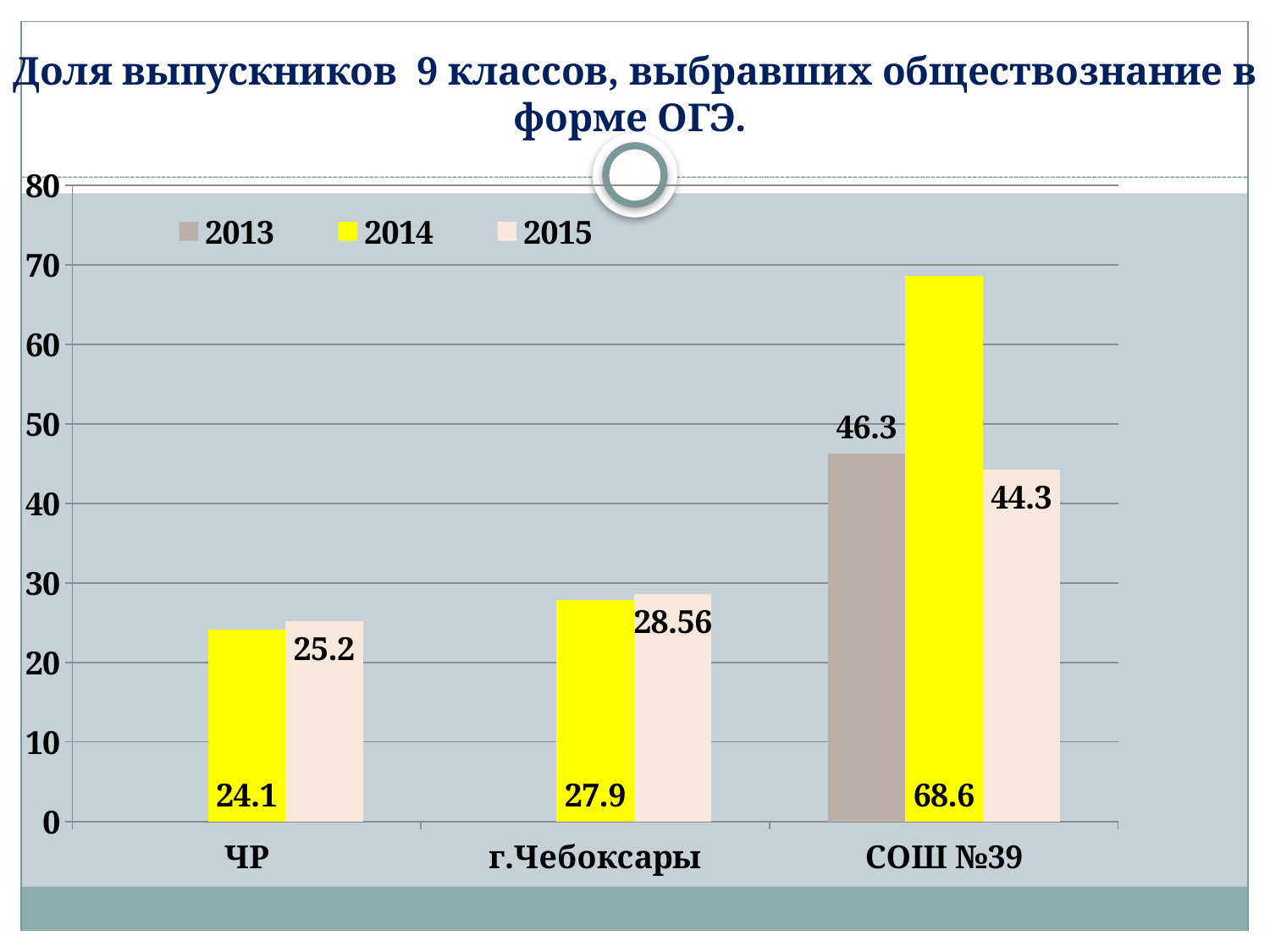
What is the value for 2014 for ЧР? 24.1 Which series is shown in yellow in the legend? 2014 What is the value for 2013 for СОШ №39? 46.3 Which is larger for ЧР: the 2014 value or the 2015 value? 2015 What kind of chart is shown on the slide? bar chart How many series does the legend list? 3 How many categories are shown on the x axis? 3 Which category has the lowest value for 2014? ЧР Which category has the highest value for 2015? СОШ №39 What is the difference between the 2014 and 2015 values for СОШ №39? 24.3 What is the value for 2015 for г.Чебоксары? 28.56 What is the value for 2014 for СОШ №39? 68.6